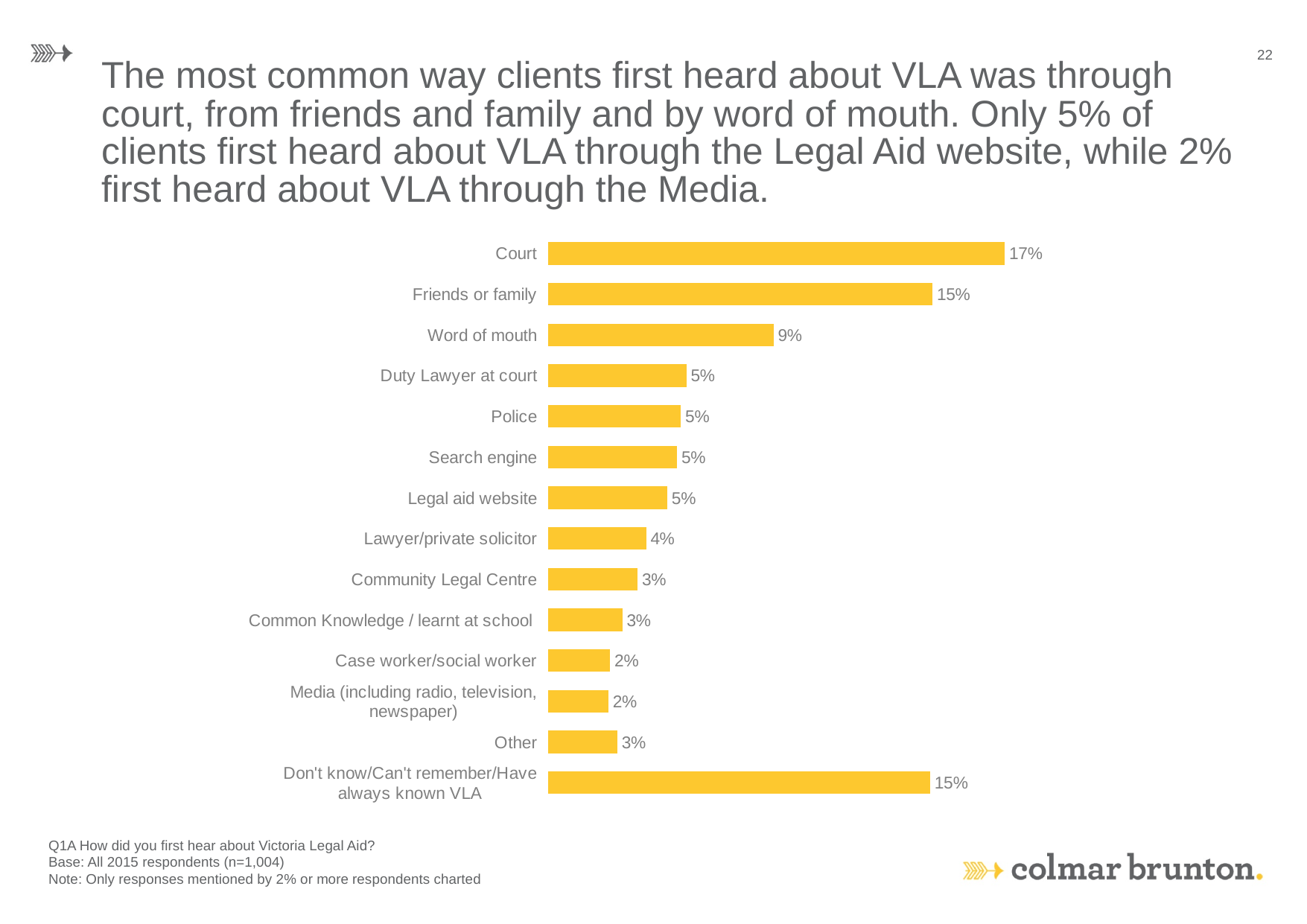
What is the difference between the values for Court and Friends or family? 2% Which category has the highest value? Court What is the difference between the values for Friends or family and Word of mouth? 6% What colour are the bars in the chart? Yellow What percentage of clients first heard about VLA through Court? 17% What percentage of clients first heard about VLA through a Lawyer/private solicitor? 4% What is the value for Media (including radio, television, newspaper)? 2% How many categories are shown in the chart? 14 Which is larger, the value for Word of mouth or the value for Police? Word of mouth Which is larger, the value for Community Legal Centre or the value for Lawyer/private solicitor? Lawyer/private solicitor What is the value for Word of mouth? 9% What kind of chart is shown on the slide? Bar chart